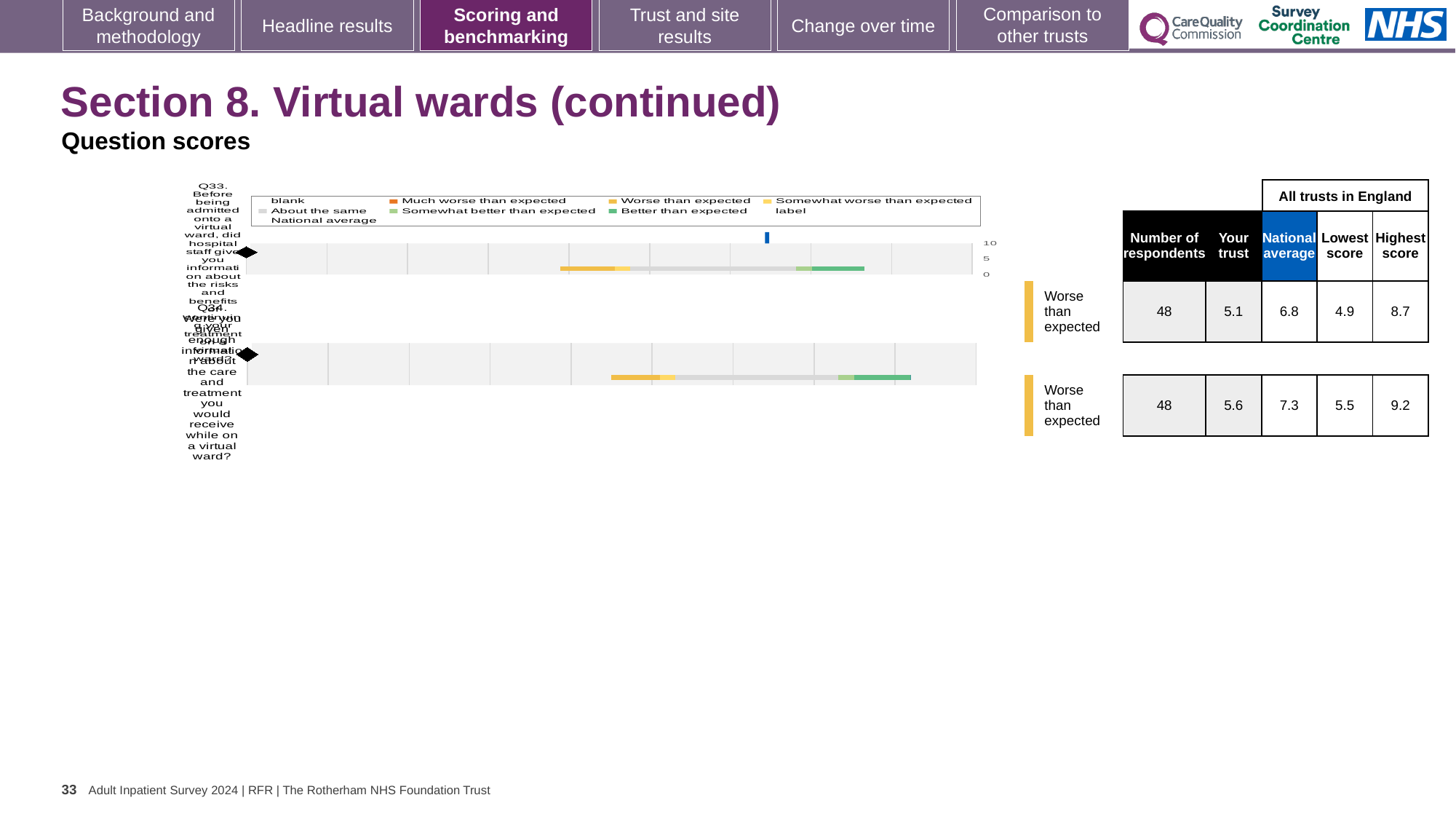
How many questions are plotted in the chart on this slide? 2 What is the highest score among all trusts in England for Q34? 9.2 What is the national average score for Q33? 6.8 What is the difference between the national average and the trust's score for Q33? 1.7 What is the national average score for Q34? 7.3 How many respondents answered Q33? 48 What is the difference between the highest scores for Q34 and Q33? 0.5 What benchmarking category is shown next to both Q33 and Q34? Worse than expected Which question has the higher 'Your trust' score, Q33 or Q34? Q34 What kind of chart is used to show the question scores on this slide? bar chart What is the 'Your trust' score for Q33 (information about the risks and benefits of a virtual ward)? 5.1 What is the 'Your trust' score for Q34 (enough information about the care and treatment on a virtual ward)? 5.6